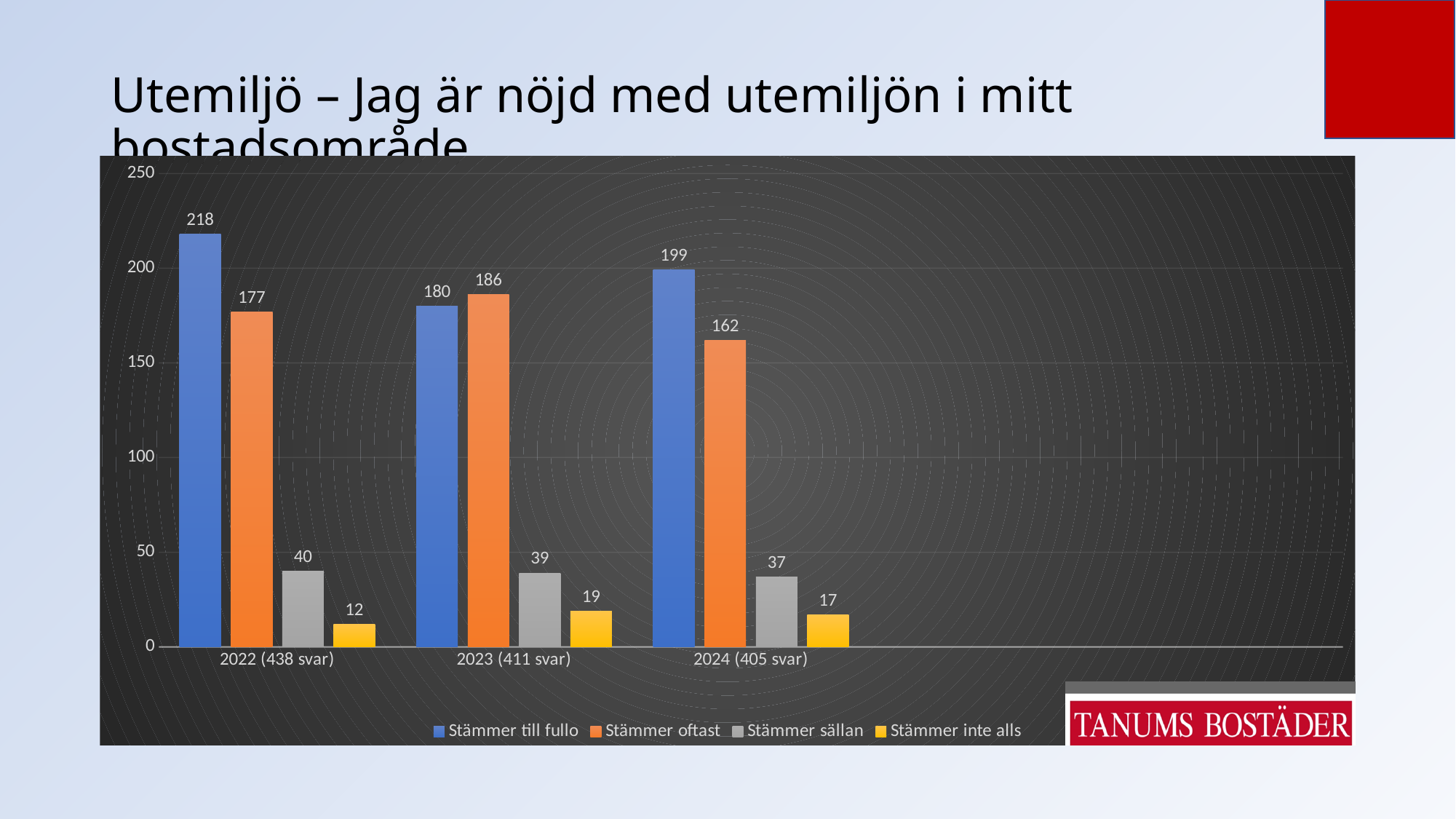
What is the difference between "Stämmer till fullo" and "Stämmer oftast" in 2024 (405 svar)? 37 How many year categories are shown on the x axis? 3 What is the value for "Stämmer inte alls" in 2024 (405 svar)? 17 In 2023 (411 svar), which is larger: "Stämmer till fullo" or "Stämmer oftast"? Stämmer oftast How many series does the legend list? 4 What kind of chart is shown on the slide? Bar chart What is the value for "Stämmer till fullo" in 2022 (438 svar)? 218 Which year has the highest value for "Stämmer till fullo"? 2022 (438 svar) What is the value for "Stämmer sällan" in 2022 (438 svar)? 40 Which colour represents "Stämmer sällan" in the legend? Grey What is the value for "Stämmer oftast" in 2023 (411 svar)? 186 Which year has the lowest value for "Stämmer inte alls"? 2022 (438 svar)